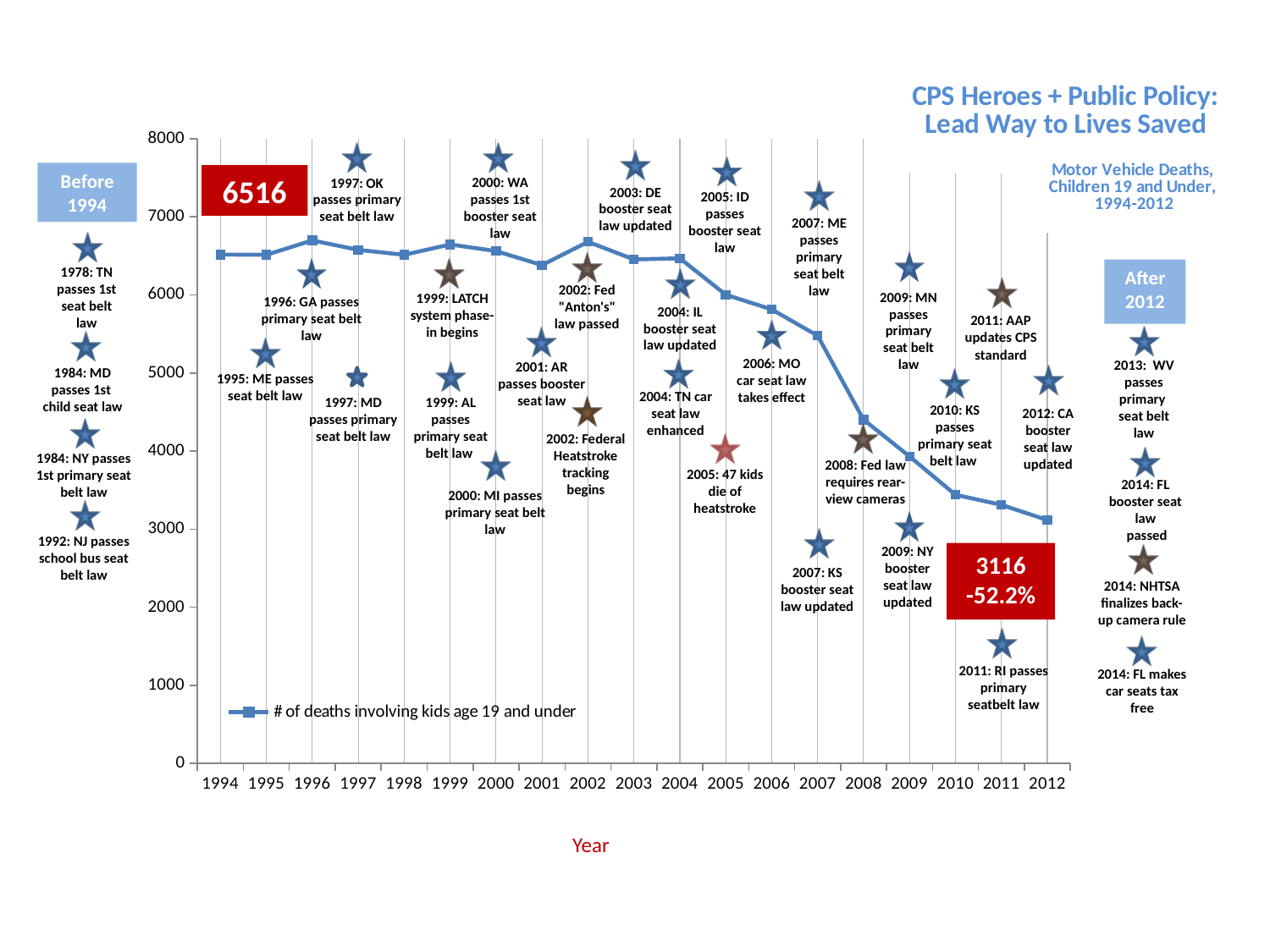
What percentage change in deaths is printed on the chart for 2012 relative to 1994? -52.2% Is the value for 2006 greater or less than 5000? greater Which year has the lowest number of deaths on the chart? 2012 How many years are shown on the x axis of the chart? 19 Do the values generally rise or fall from 1994 to 2012? fall What is the number of deaths involving kids age 19 and under in 2012? 3116 What kind of chart is shown on the slide? line chart What is the number of deaths involving kids age 19 and under in 1994? 6516 Which year has more deaths, 1994 or 2012? 1994 Is the value for 2010 greater or less than 4000? less Is the value for 2008 greater or less than 5000? less What is the difference between the number of deaths in 1994 and in 2012? 3400